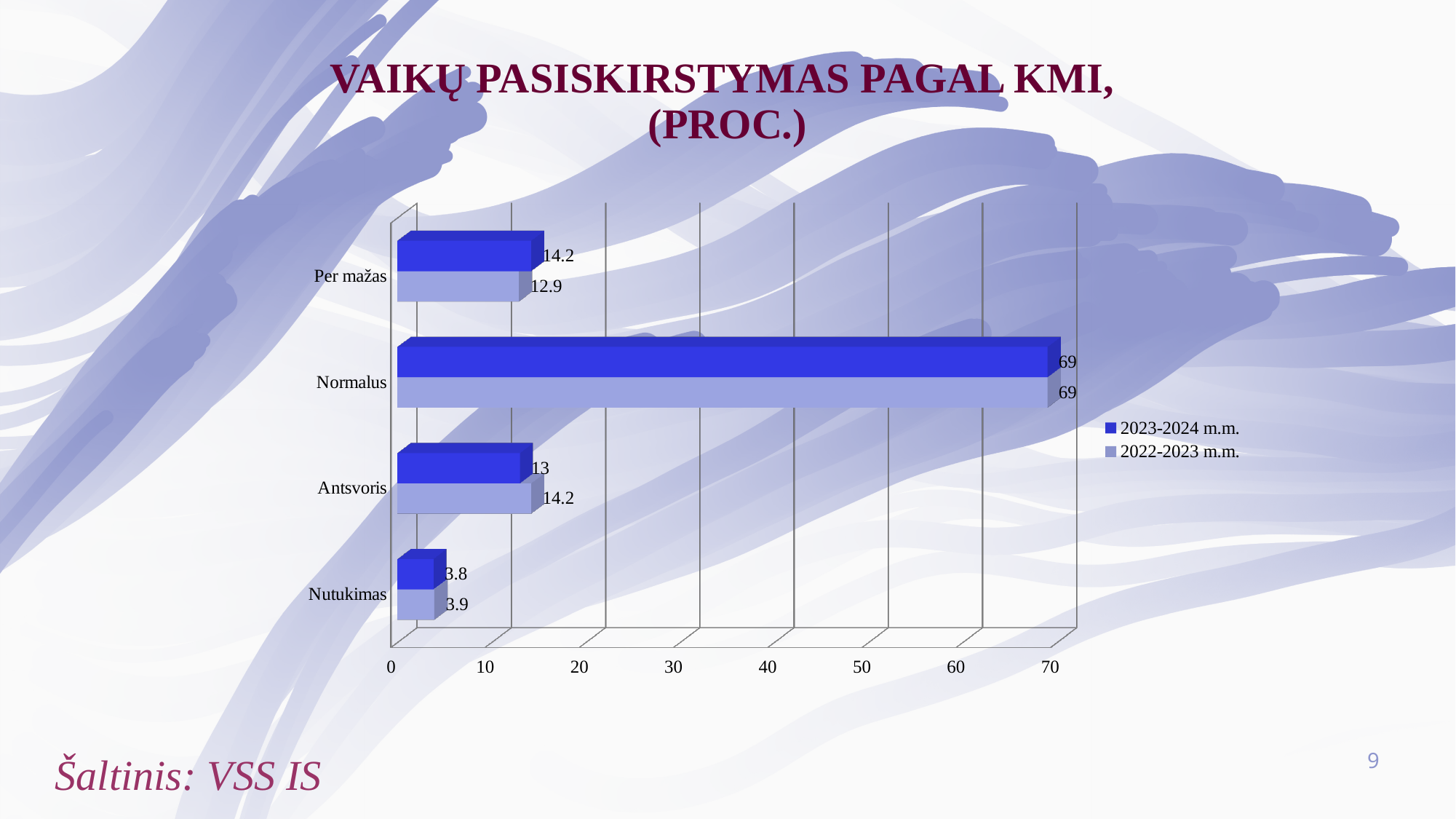
What is the value for Nutukimas in the 2023-2024 m.m. series? 3.8 What kind of chart is shown on the slide? Bar chart Which is larger for Antsvoris: the 2023-2024 m.m. value or the 2022-2023 m.m. value? 2022-2023 m.m. Which category has the lowest value in the 2022-2023 m.m. series? Nutukimas Which category has the highest value in the 2023-2024 m.m. series? Normalus What is the value for Per mažas in the 2022-2023 m.m. series? 12.9 How many series does the legend list? 2 What is the value for Antsvoris in the 2022-2023 m.m. series? 14.2 How many categories are shown on the chart? 4 What is the value for Per mažas in the 2023-2024 m.m. series? 14.2 What is the difference between the 2022-2023 m.m. and 2023-2024 m.m. values for Antsvoris? 1.2 What is the difference between the 2023-2024 m.m. and 2022-2023 m.m. values for Per mažas? 1.3